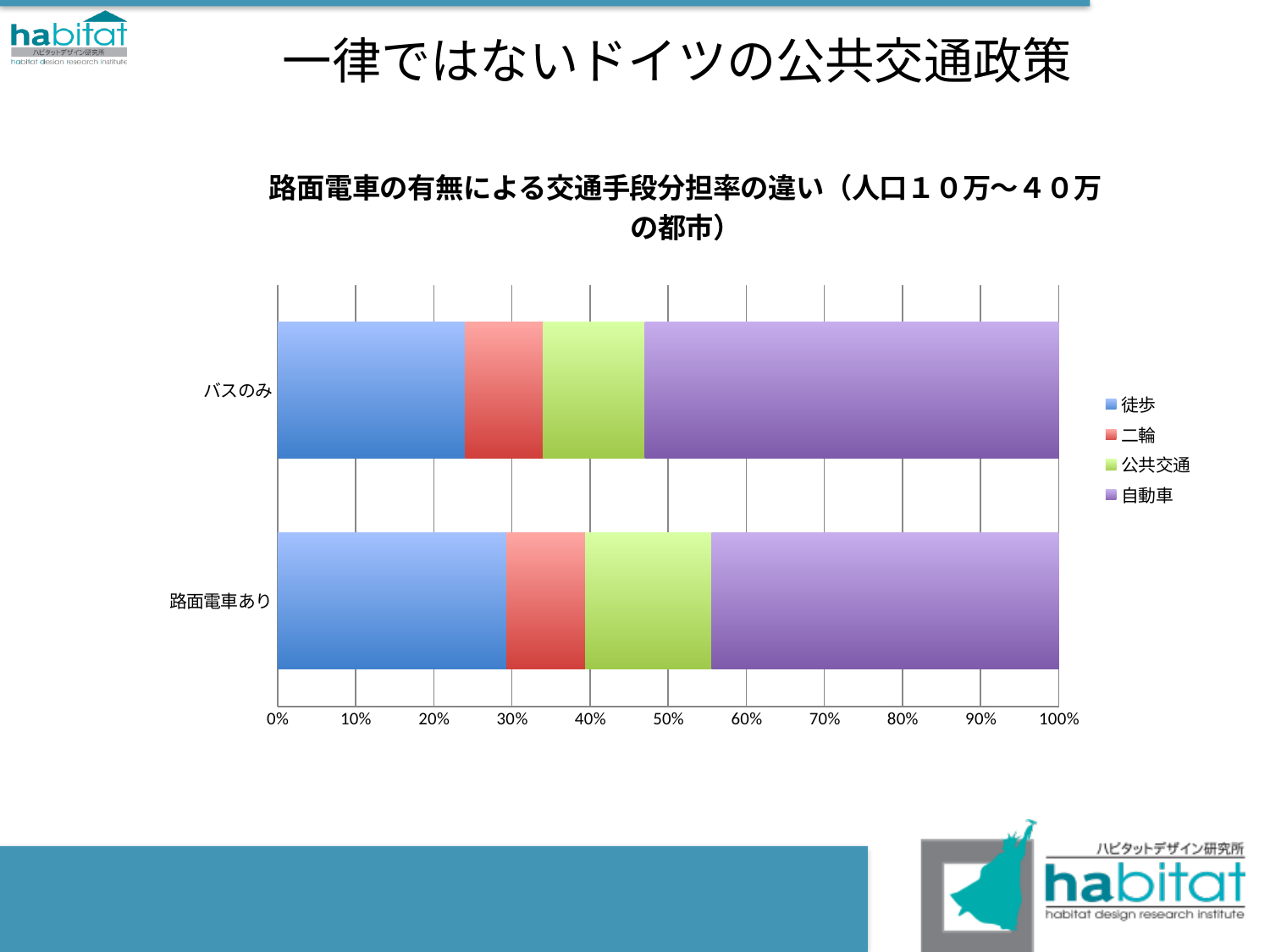
Is the 徒歩 share larger for バスのみ or for 路面電車あり? 路面電車あり Which series is shown in purple in the legend? 自動車 Which series has the smallest share in the 路面電車あり bar? 二輪 Which series has the largest share in the バスのみ bar? 自動車 Is the 徒歩 share for バスのみ greater or less than 30%? less Is the 自動車 share for 路面電車あり greater or less than 50%? less What kind of chart is shown on the slide? Stacked bar chart What is the title of the chart? 路面電車の有無による交通手段分担率の違い（人口１０万～４０万の都市） Is the 公共交通 share larger for バスのみ or for 路面電車あり? 路面電車あり Is the 自動車 share larger for バスのみ or for 路面電車あり? バスのみ How many categories (bars) does the chart show? 2 How many series does the legend list? 4